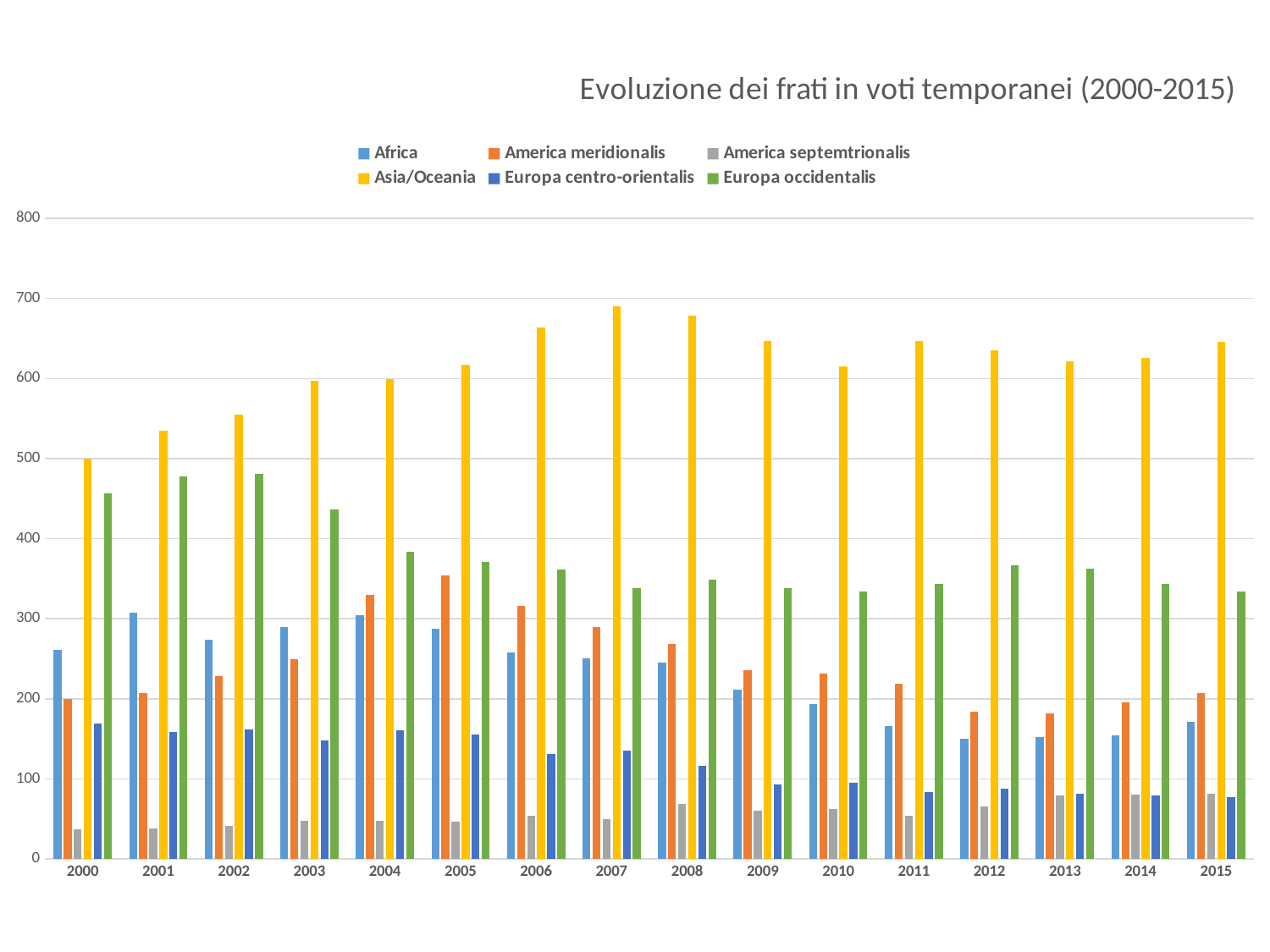
Is the value for Africa in 2015 greater or less than 200? less In 2015, which is larger: Africa or America meridionalis? America meridionalis How many series does the legend list? 6 What is the title of the chart? Evoluzione dei frati in voti temporanei (2000-2015) What kind of chart is shown on the slide? bar chart Which series has the lowest value in 2005? America septemtrionalis Is the value for Asia/Oceania in 2007 greater or less than 600? greater Do the values for Europa occidentalis rise or fall overall from 2000 to 2015? fall How many years are shown along the x axis? 16 Which series has the highest value in 2010? Asia/Oceania Is the value for America meridionalis in 2005 greater or less than 300? greater In which year does Asia/Oceania reach its highest value? 2007